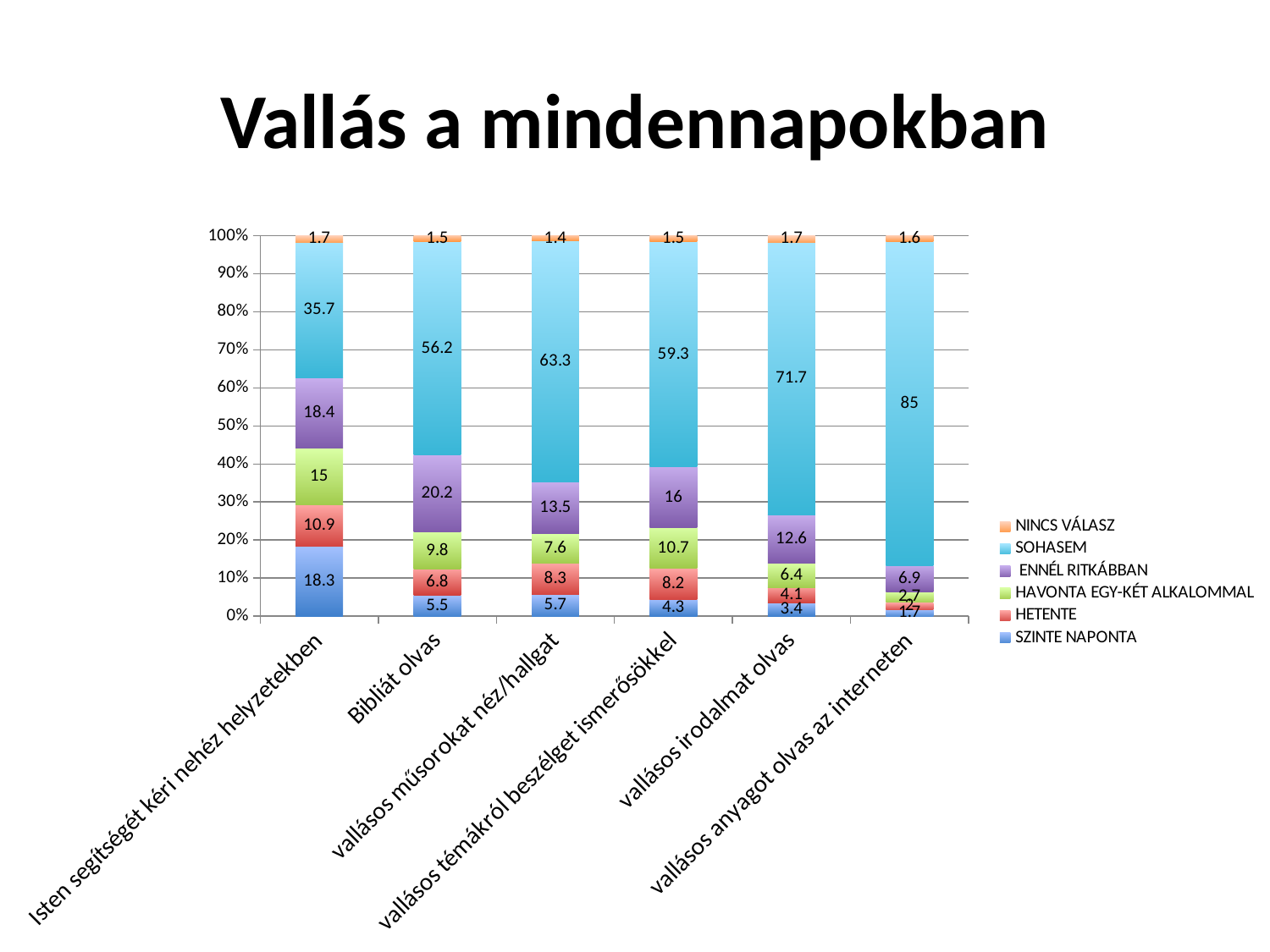
What kind of chart is shown on the slide? Stacked bar chart How many series does the legend list? 6 What is the difference between the SZINTE NAPONTA values for 'Isten segítségét kéri nehéz helyzetekben' and 'Bibliát olvas'? 12.8 What is the difference between the SOHASEM values for 'vallásos irodalmat olvas' and 'vallásos műsorokat néz/hallgat'? 8.4 Which category has the highest SOHASEM value? vallásos anyagot olvas az interneten How many categories are shown on the x axis of the chart? 6 What is the SOHASEM value for the category 'Bibliát olvas'? 56.2 What is the SZINTE NAPONTA value for 'Isten segítségét kéri nehéz helyzetekben'? 18.3 What is the ENNÉL RITKÁBBAN value for 'vallásos irodalmat olvas'? 12.6 What is the HAVONTA EGY-KÉT ALKALOMMAL value for 'vallásos témákról beszélget ismerősökkel'? 10.7 Which category has the lowest SOHASEM value? Isten segítségét kéri nehéz helyzetekben Which has the larger HETENTE value: 'Bibliát olvas' or 'vallásos műsorokat néz/hallgat'? vallásos műsorokat néz/hallgat